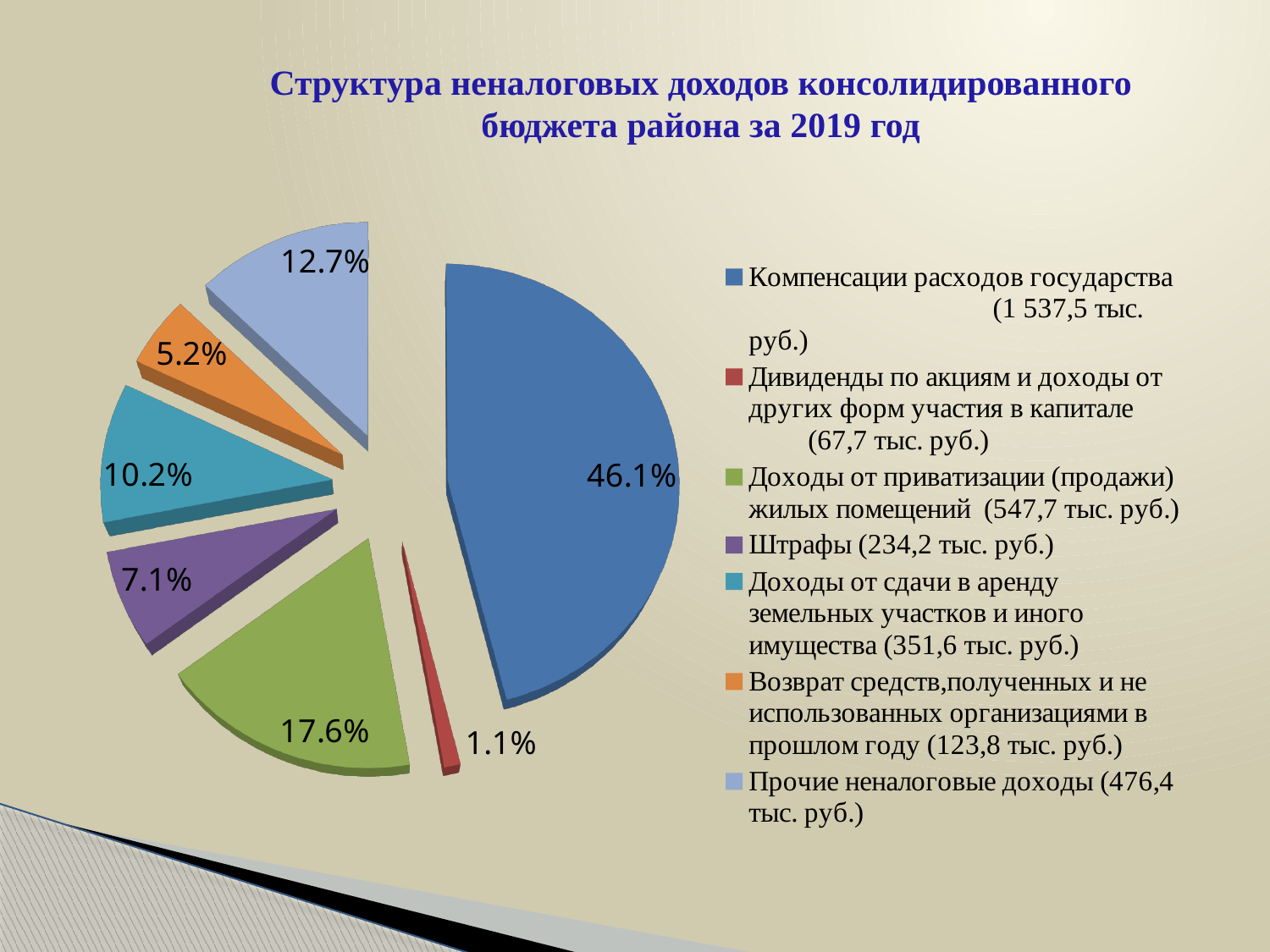
What share of the pie does "Компенсации расходов государства" have? 46.1% What kind of chart is shown on the slide? Pie chart What is the title of the chart on the slide? Структура неналоговых доходов консолидированного бюджета района за 2019 год Which category has the largest slice of the pie? Компенсации расходов государства Which slice is larger: "Штрафы" or "Доходы от сдачи в аренду земельных участков и иного имущества"? Доходы от сдачи в аренду земельных участков и иного имущества What share of the pie does "Штрафы" have? 7.1% Which category has the smallest slice of the pie? Дивиденды по акциям и доходы от других форм участия в капитале What share of the pie does "Прочие неналоговые доходы" have? 12.7% How many slices does the pie chart have? 7 What is the difference in percentage points between the "Доходы от сдачи в аренду земельных участков и иного имущества" slice and the "Возврат средств, полученных и не использованных организациями в прошлом году" slice? 5.0% According to the legend, what amount in тыс. руб. corresponds to "Штрафы"? 234,2 тыс. руб.